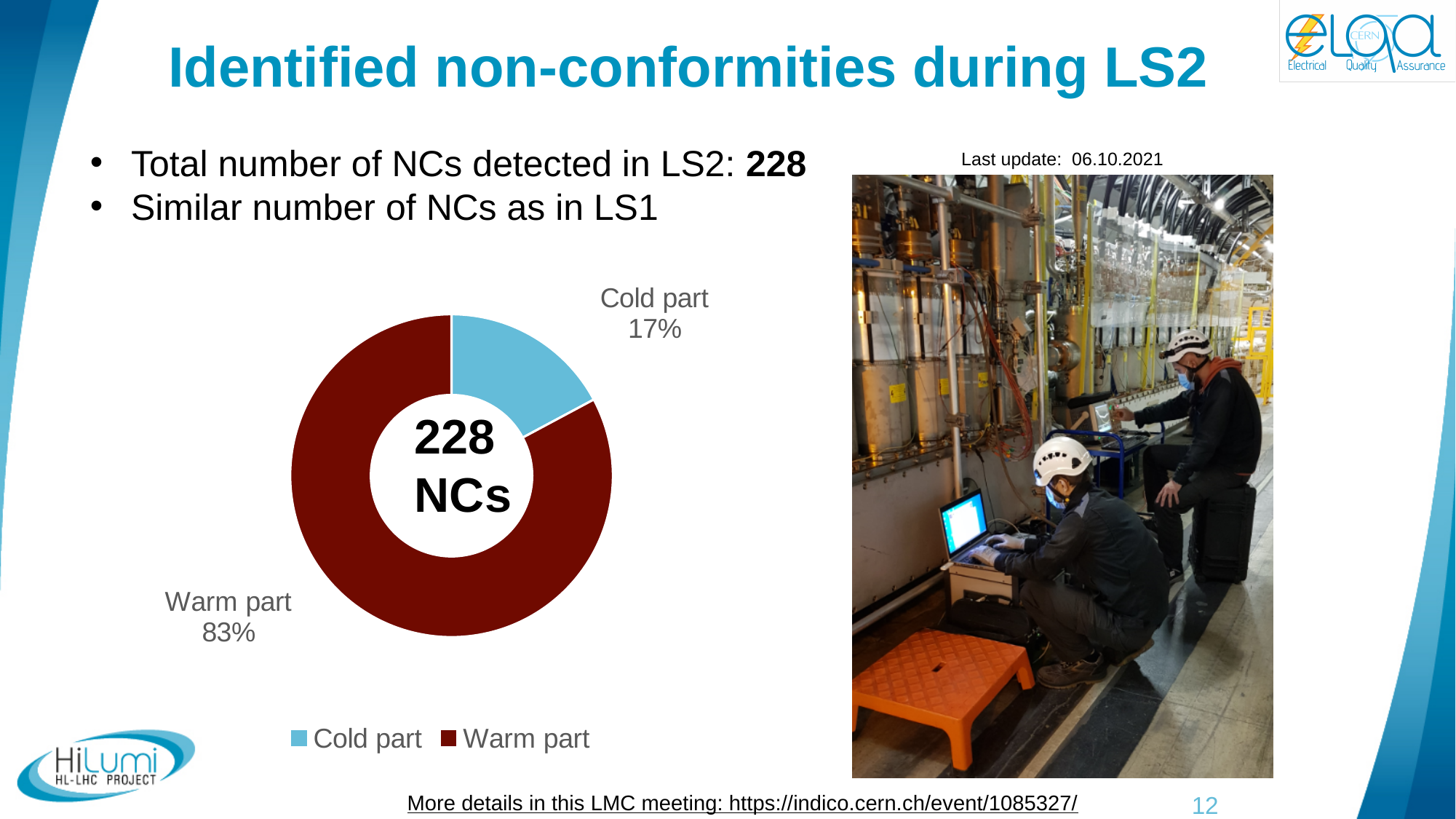
What share of the 228 NCs is the Cold part? 17% How many categories does the chart show? 2 What colour represents the Cold part in the chart? Light blue Which part accounts for the largest share of NCs? Warm part What colour represents the Warm part in the chart? Dark red What is the difference in percentage points between the Warm part and Cold part shares? 66 What share of the 228 NCs is the Warm part? 83% Which part accounts for the smallest share of NCs? Cold part What total number is printed in the centre of the chart? 228 NCs How many entries does the chart legend list? 2 What kind of chart is shown on the slide? Pie chart (doughnut) Which is larger, the Cold part share or the Warm part share? Warm part